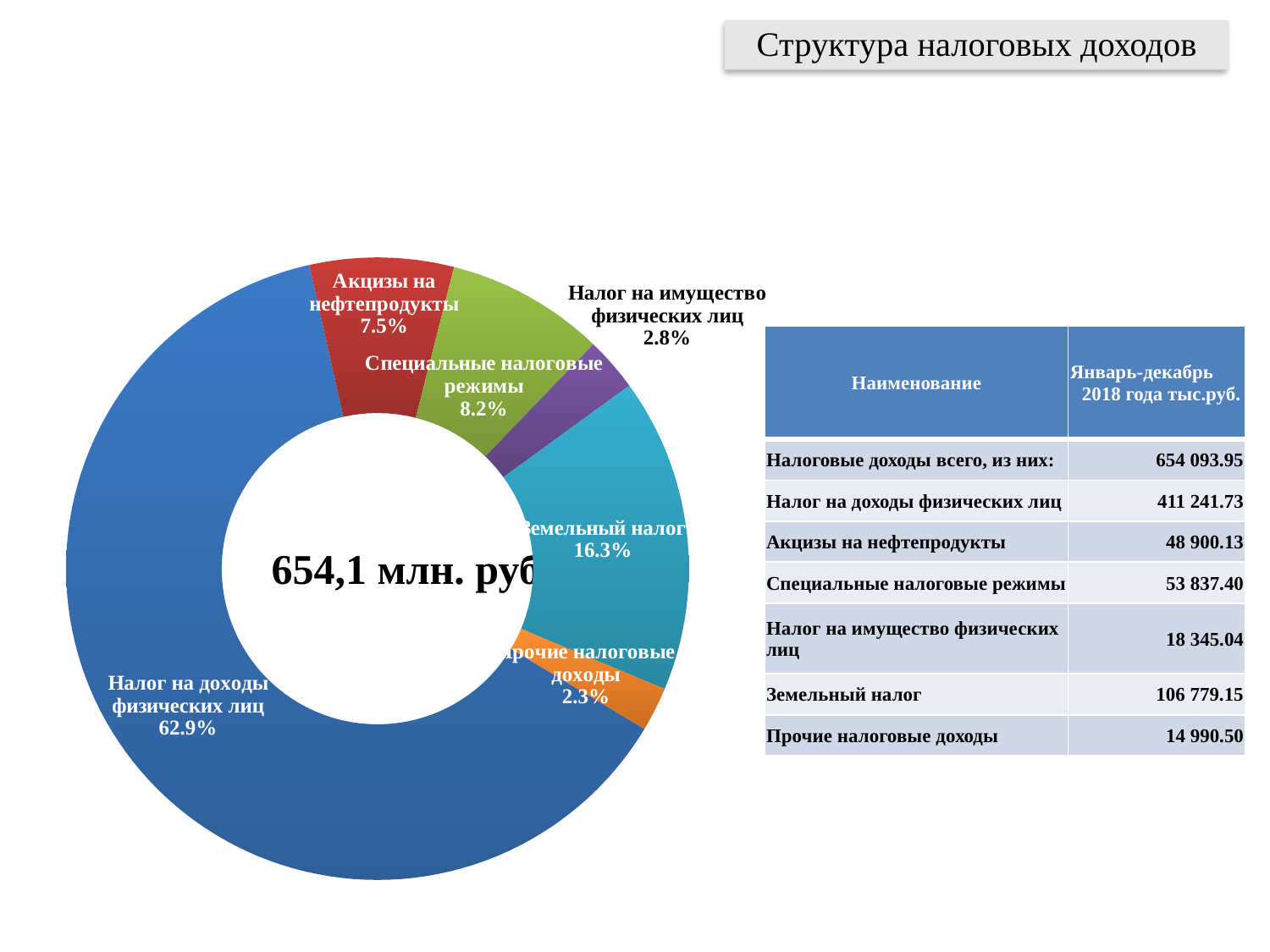
What percentage is shown for Земельный налог in the chart? 16.3% What percentage is shown for Специальные налоговые режимы in the chart? 8.2% What is the difference in percentage points between Земельный налог and Специальные налоговые режимы? 8.1 What total amount is printed in the centre of the chart? 654,1 млн. руб. What type of chart is shown on the slide? Pie (doughnut) chart What share of tax revenues does Налог на доходы физических лиц account for in the chart? 62.9% How many categories are shown in the chart? 6 What percentage is shown for Налог на имущество физических лиц in the chart? 2.8% Which is larger in the chart: Специальные налоговые режимы or Акцизы на нефтепродукты? Специальные налоговые режимы What percentage is shown for Акцизы на нефтепродукты in the chart? 7.5% Which category has the largest share in the chart? Налог на доходы физических лиц Which category has the smallest share in the chart? Прочие налоговые доходы